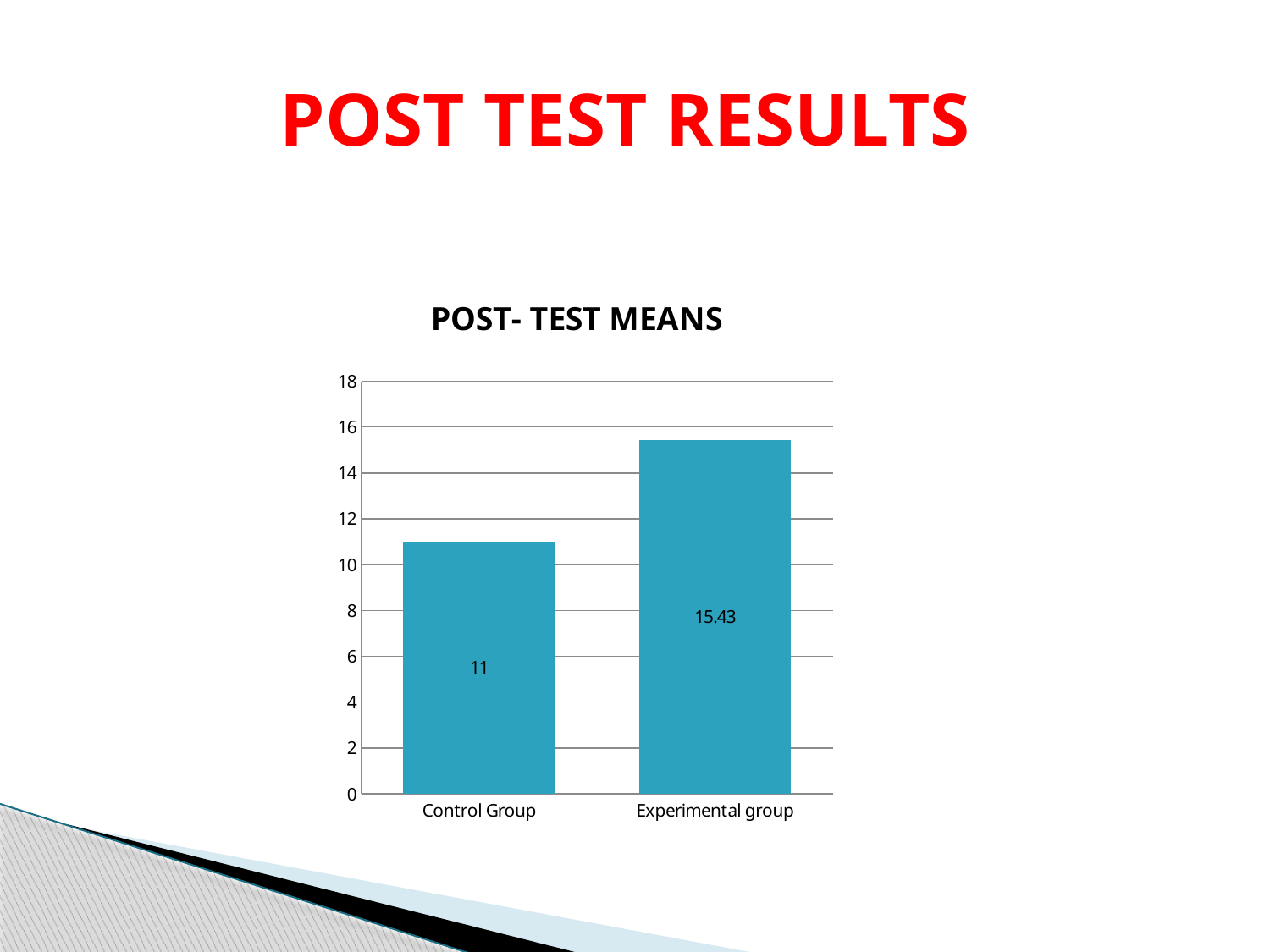
How many categories are shown on the chart? 2 What is the title of the chart? POST- TEST MEANS Which category has the lowest value? Control Group Which category has the highest value? Experimental group Is the value for Experimental group greater or less than 14? greater What is the value for Experimental group? 15.43 What is the highest value shown on the vertical axis? 18 What is the difference between the Experimental group and Control Group values? 4.43 Which is larger, the value for Control Group or the value for Experimental group? Experimental group Is the value for Control Group greater or less than 12? less What kind of chart is shown on the slide? bar chart What is the value for Control Group? 11